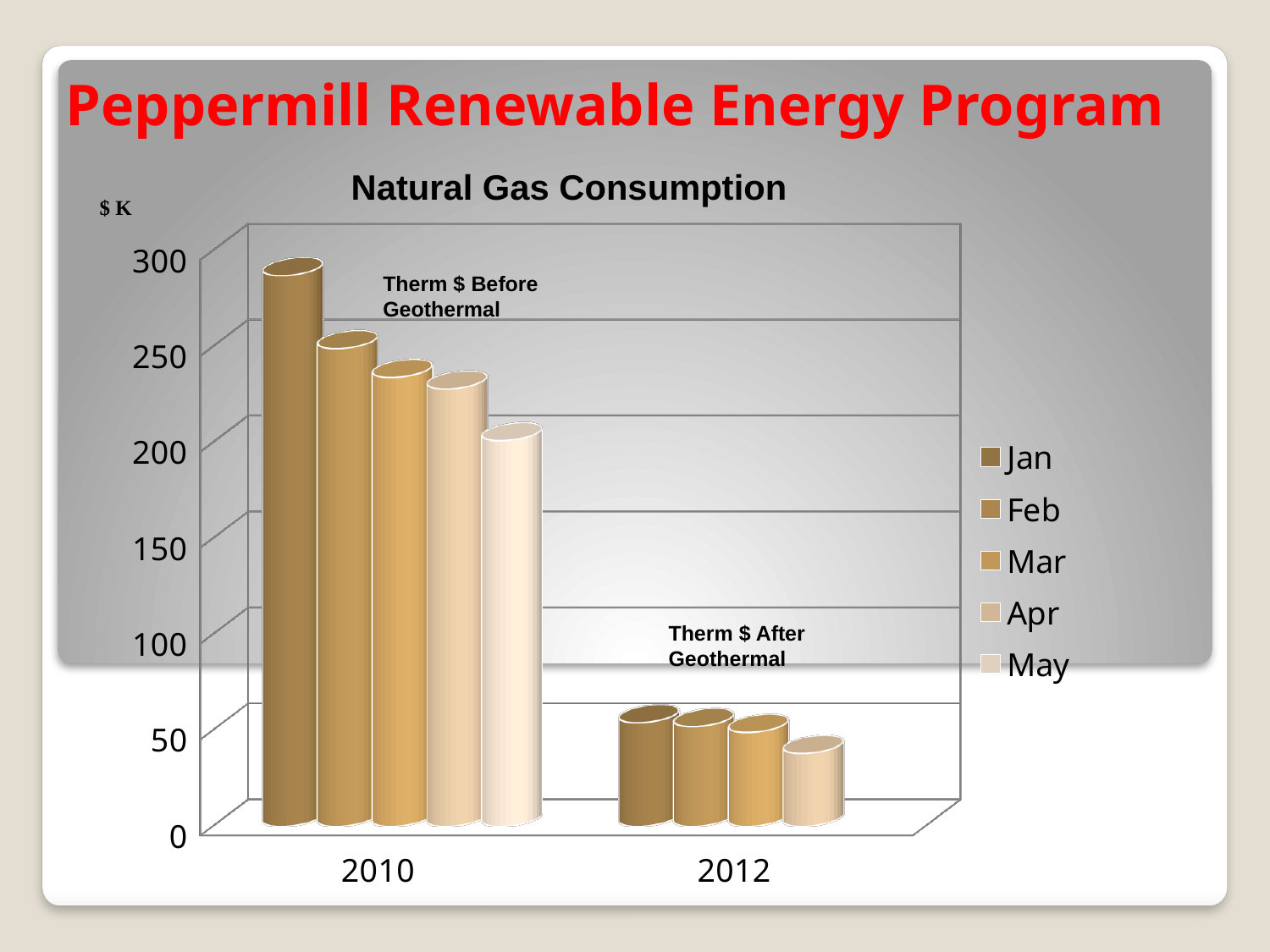
Which month has the lowest value in 2012? Apr Do the values rise or fall from 2010 to 2012? fall Which month has the lowest value in 2010? May How many categories are shown on the x axis? 2 What is the title of the chart? Natural Gas Consumption Is the value for May in 2010 greater or less than 150? greater How many series does the legend list? 5 Is the value for Jan in 2012 greater or less than 100? less Is the value for Jan in 2010 greater or less than 250? greater Which is larger, the value for Jan in 2010 or the value for Jan in 2012? Jan in 2010 Which month has the highest value in 2010? Jan What kind of chart is shown on the slide? bar chart